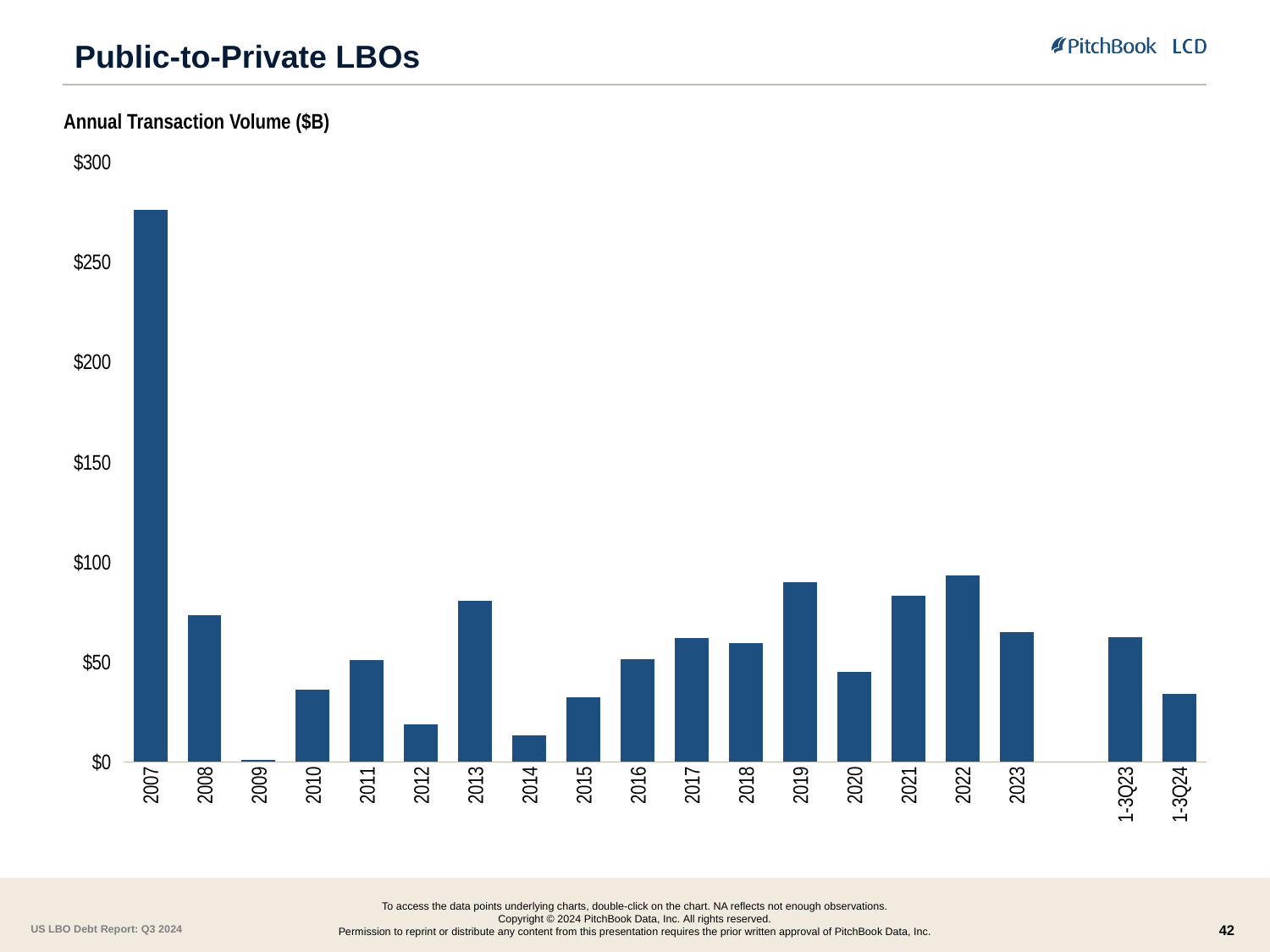
Is the value for 1-3Q24 greater or less than $50? less Which is larger, the value for 1-3Q23 or the value for 1-3Q24? 1-3Q23 Which year has the highest annual transaction volume? 2007 Is the value for 2012 greater or less than $50? less Which year has the lowest annual transaction volume? 2009 How many bars are plotted on the chart? 19 Is the value for 2007 greater or less than $250? greater What kind of chart is shown on the slide? bar chart Which is larger, the value for 2019 or the value for 2020? 2019 What is the title of the chart? Annual Transaction Volume ($B)